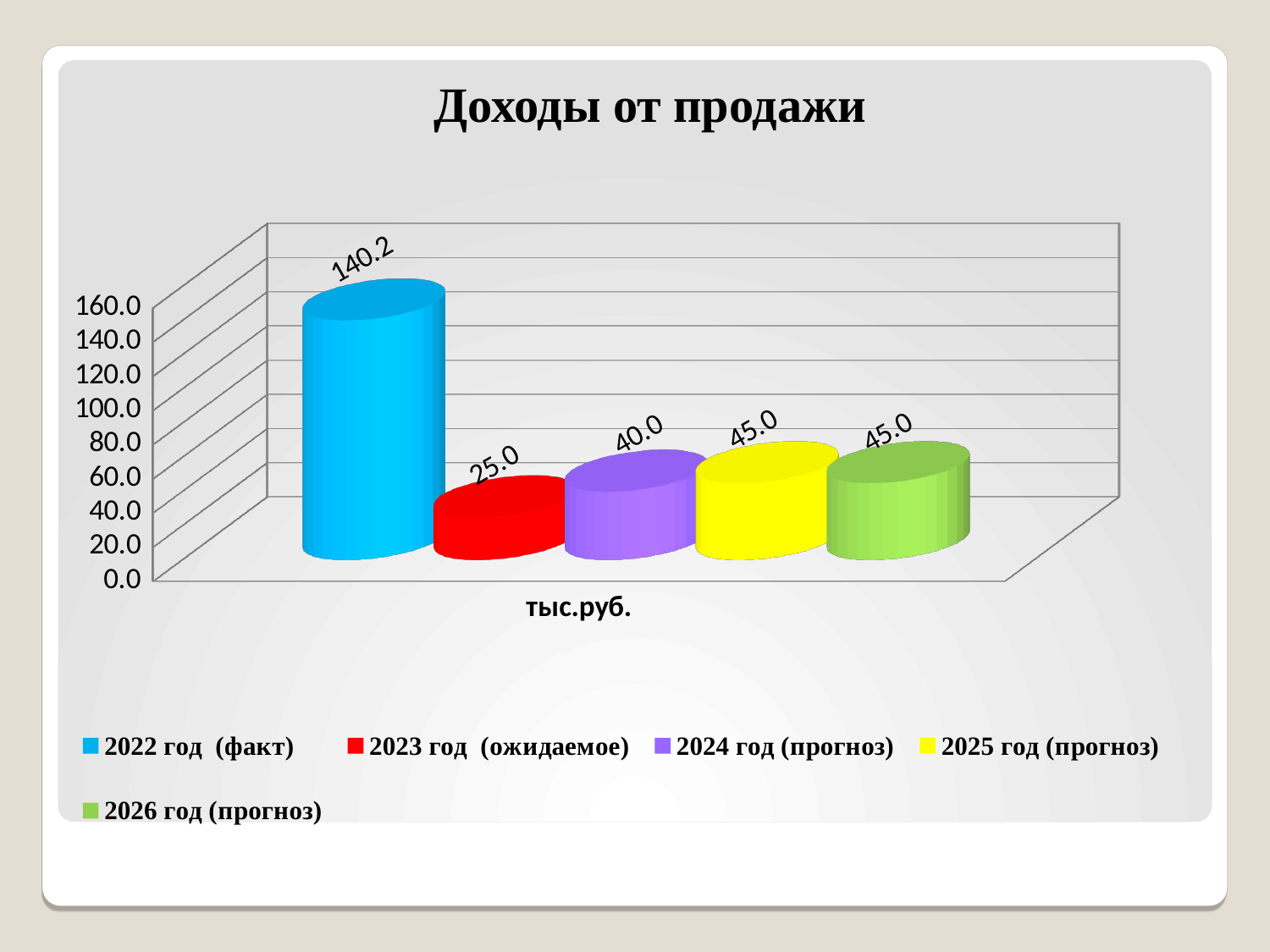
Which series has the lowest value? 2023 год (ожидаемое) What is the title of the chart? Доходы от продажи How many series does the legend list? 5 What kind of chart is shown on the slide? Bar chart What is the value for 2025 год (прогноз)? 45.0 What is the value for 2023 год (ожидаемое)? 25.0 What is the difference between the values for 2022 год (факт) and 2023 год (ожидаемое)? 115.2 Which series has the highest value? 2022 год (факт) What is the value for 2022 год (факт)? 140.2 Which is larger, the value for 2024 год (прогноз) or the value for 2023 год (ожидаемое)? 2024 год (прогноз) What is the value for 2024 год (прогноз)? 40.0 What is the difference between the values for 2025 год (прогноз) and 2024 год (прогноз)? 5.0